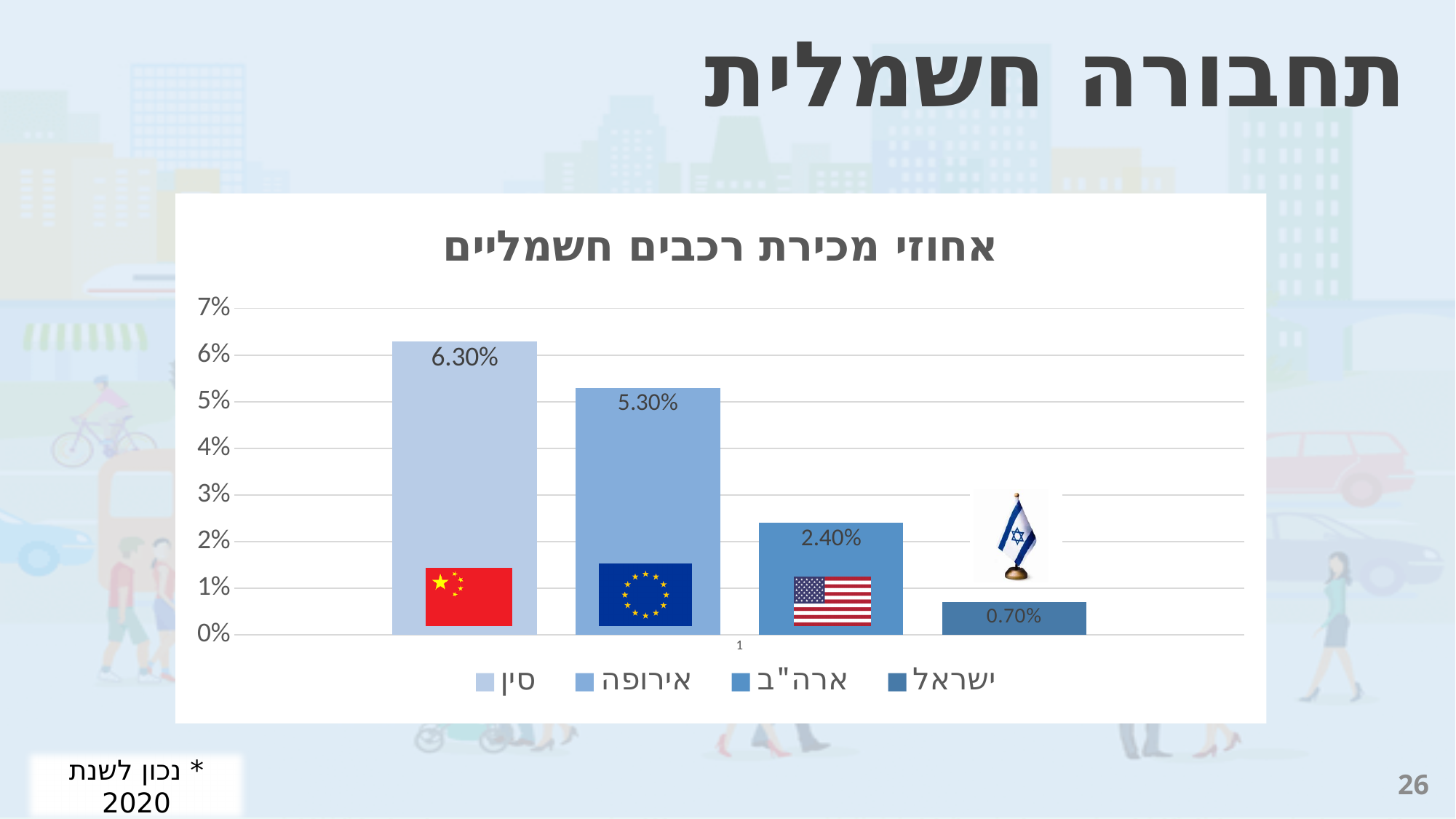
Which series has the lowest value in the chart? ישראל How many series does the legend list? 4 What is the value for ישראל (Israel) in the chart? 0.70% What is the value for סין (China) in the chart? 6.30% What is the value for אירופה (Europe) in the chart? 5.30% What is the difference between the values for ארה"ב and ישראל? 1.70% What kind of chart is shown on the slide? bar chart What is the difference between the values for סין and אירופה? 1.00% What is the value for ארה"ב (USA) in the chart? 2.40% Which series has the highest value in the chart? סין Which is larger, the value for אירופה or the value for ארה"ב? אירופה What is the title of the chart? אחוזי מכירת רכבים חשמליים